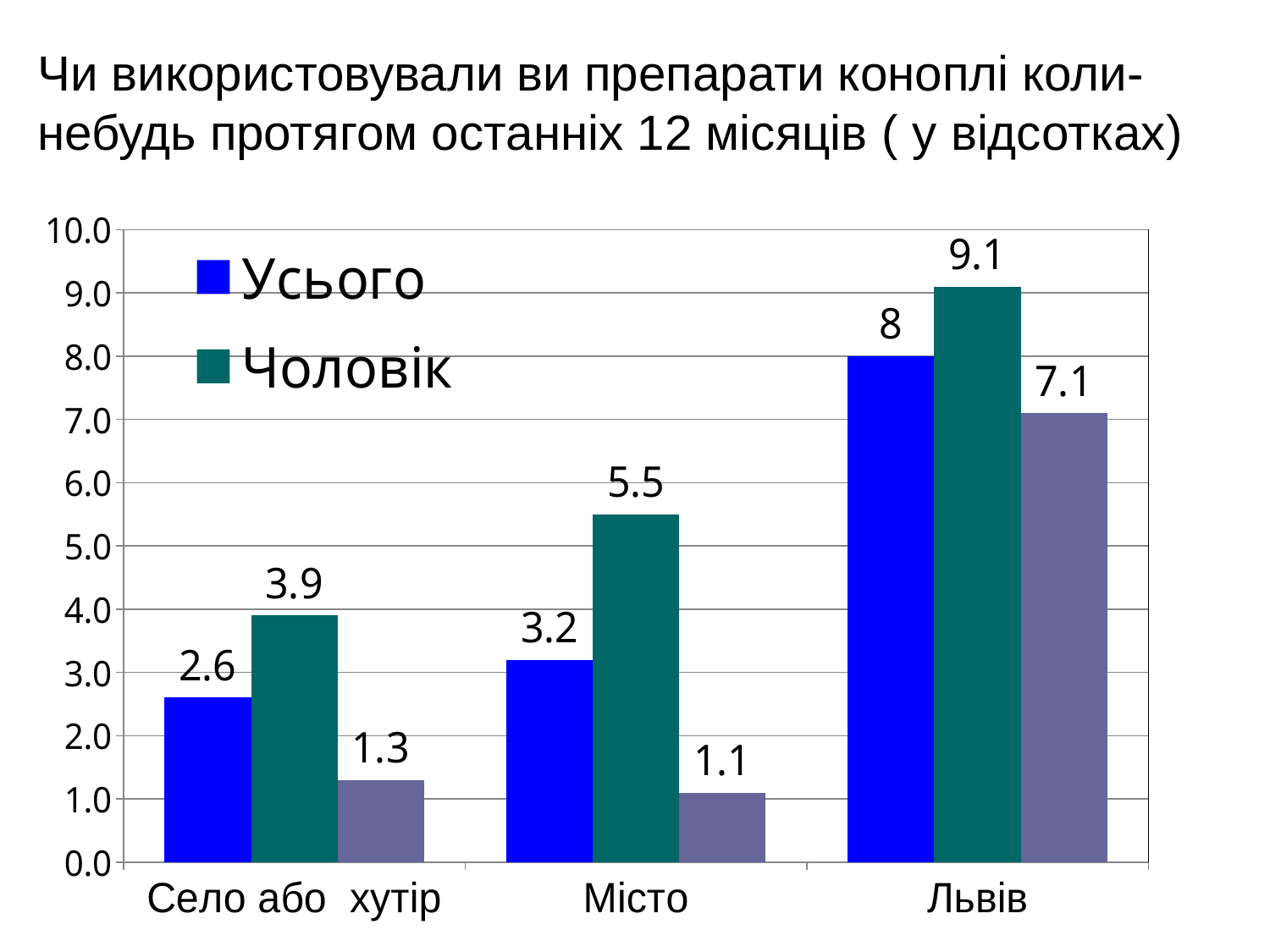
What is the value for Усього in the Львів category? 8 What is the difference between the Чоловік and Усього values in the Львів category? 1.1 Which category has the highest value for Чоловік? Львів What is the value for Чоловік in the Село або хутір category? 3.9 What kind of chart is shown on the slide? Bar chart Which is larger in the Місто category: Усього or Чоловік? Чоловік What is the value for Чоловік in the Місто category? 5.5 How many categories are shown on the x axis? 3 Which category has the lowest value for Усього? Село або хутір How many series does the legend list? 2 What is the value for Усього in the Село або хутір category? 2.6 Do the Усього values rise or fall from Село або хутір to Львів? Rise